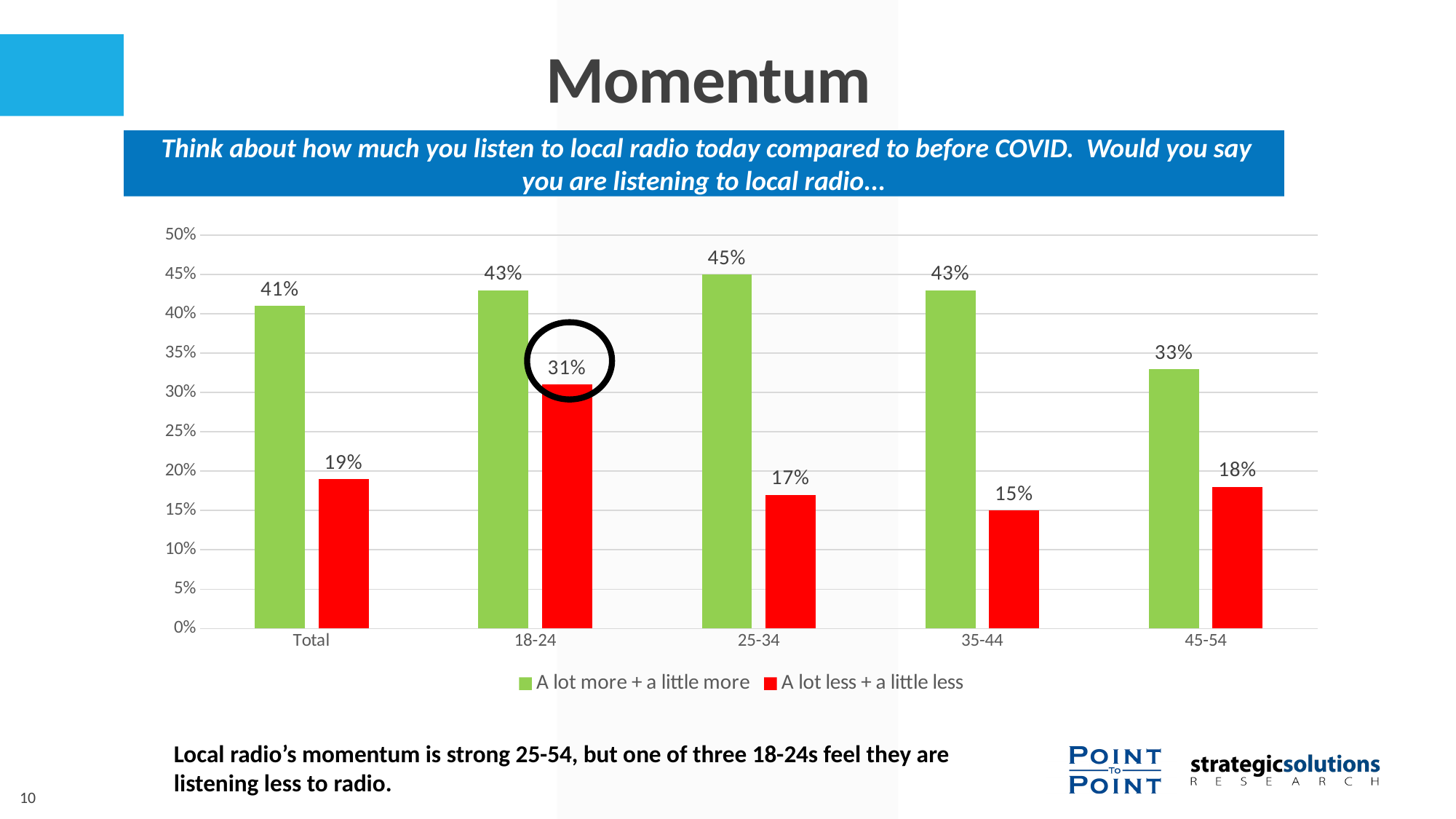
What colour represents the 'A lot less + a little less' series? Red What is the value for 'A lot more + a little more' for Total? 41% Which category has the lowest value for 'A lot less + a little less'? 35-44 How many categories are shown on the x axis? 5 What is the value for 'A lot more + a little more' in the 25-34 age group? 45% Is the value for 'A lot less + a little less' in the 18-24 group greater or less than 30%? greater How many series does the legend list? 2 What kind of chart is shown on the slide? Bar chart Which is larger for the 18-24 group: 'A lot more + a little more' or 'A lot less + a little less'? A lot more + a little more Which age group has the highest value for 'A lot more + a little more'? 25-34 What is the value for 'A lot less + a little less' in the 18-24 age group? 31% What is the difference between 'A lot more + a little more' and 'A lot less + a little less' for the 45-54 age group? 15%